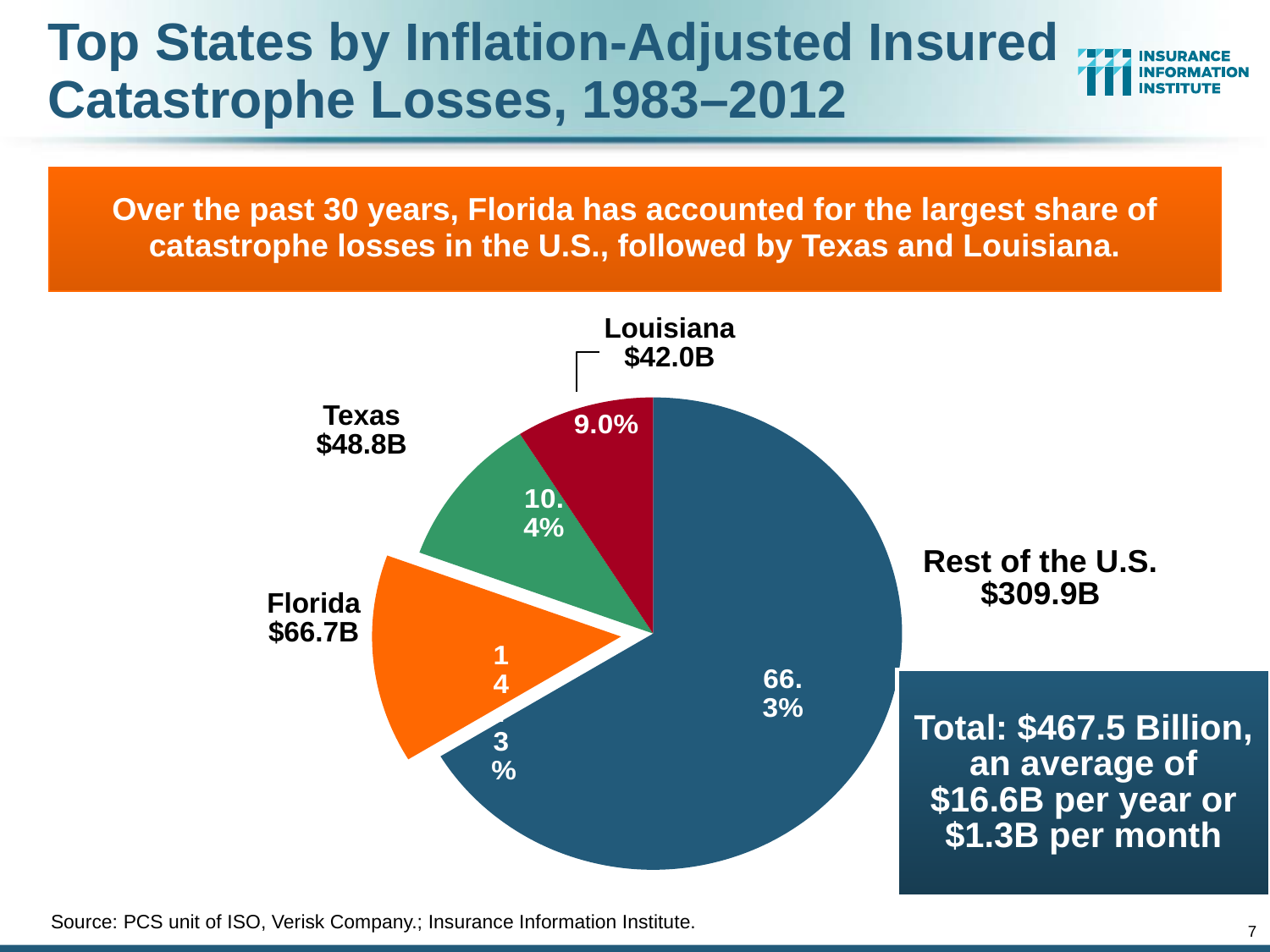
What is the value shown for Rest of the U.S.? $309.9B Which slice of the pie chart is the largest? Rest of the U.S. What is the difference between the values for Florida and Texas? $17.9B Which slice of the pie chart is the smallest? Louisiana What share of the pie does Rest of the U.S. account for? 66.3% Which has the larger value, Texas or Louisiana? Texas What is the inflation-adjusted insured catastrophe loss value shown for Florida? $66.7B What kind of chart is shown on the slide? Pie chart What share of the pie does Louisiana account for? 9.0% How many slices does the pie chart have? 4 What is the value shown for Texas? $48.8B What is the value shown for Louisiana? $42.0B